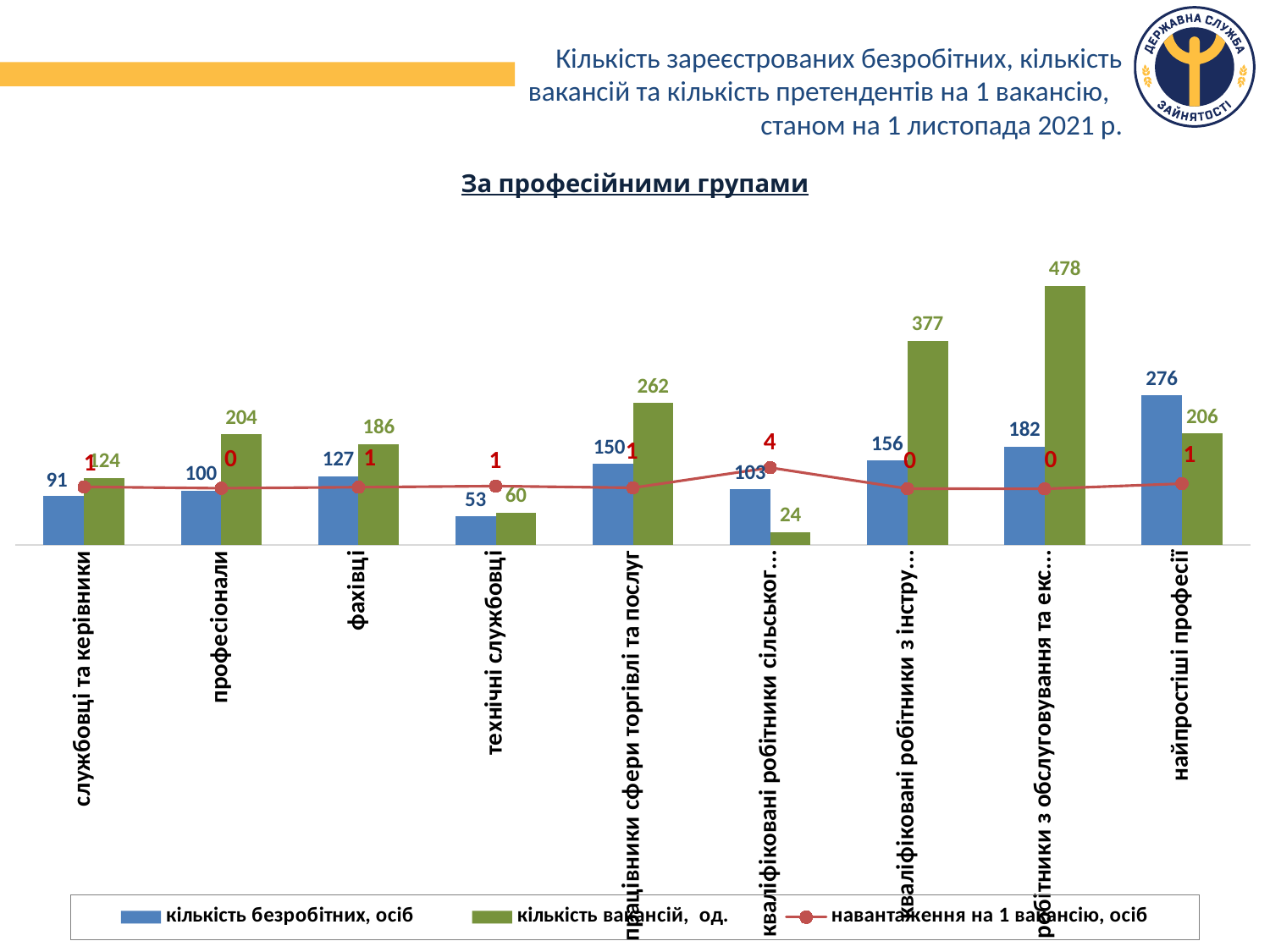
How many series does the legend list? 3 What is the number of vacancies (кількість вакансій, од.) for the category 'професіонали'? 204 What is the highest value of the line series 'навантаження на 1 вакансію, осіб' shown on the chart? 4 What is the number of vacancies (кількість вакансій, од.) for the category 'найпростіші професії'? 206 How many professional group categories are shown on the x axis? 9 What is the number of unemployed (кількість безробітних, осіб) for the category 'фахівці'? 127 What is the difference between the number of vacancies and the number of unemployed for the category 'технічні службовці'? 7 Which category has the lowest number of unemployed (кількість безробітних, осіб)? технічні службовці Which category has the highest number of unemployed (кількість безробітних, осіб)? найпростіші професії What is the subtitle shown above the chart? За професійними групами For the category 'найпростіші професії', which is larger: the number of unemployed or the number of vacancies? the number of unemployed Which category has the highest number of vacancies (кількість вакансій, од.)? робітники з обслуговування та екс...